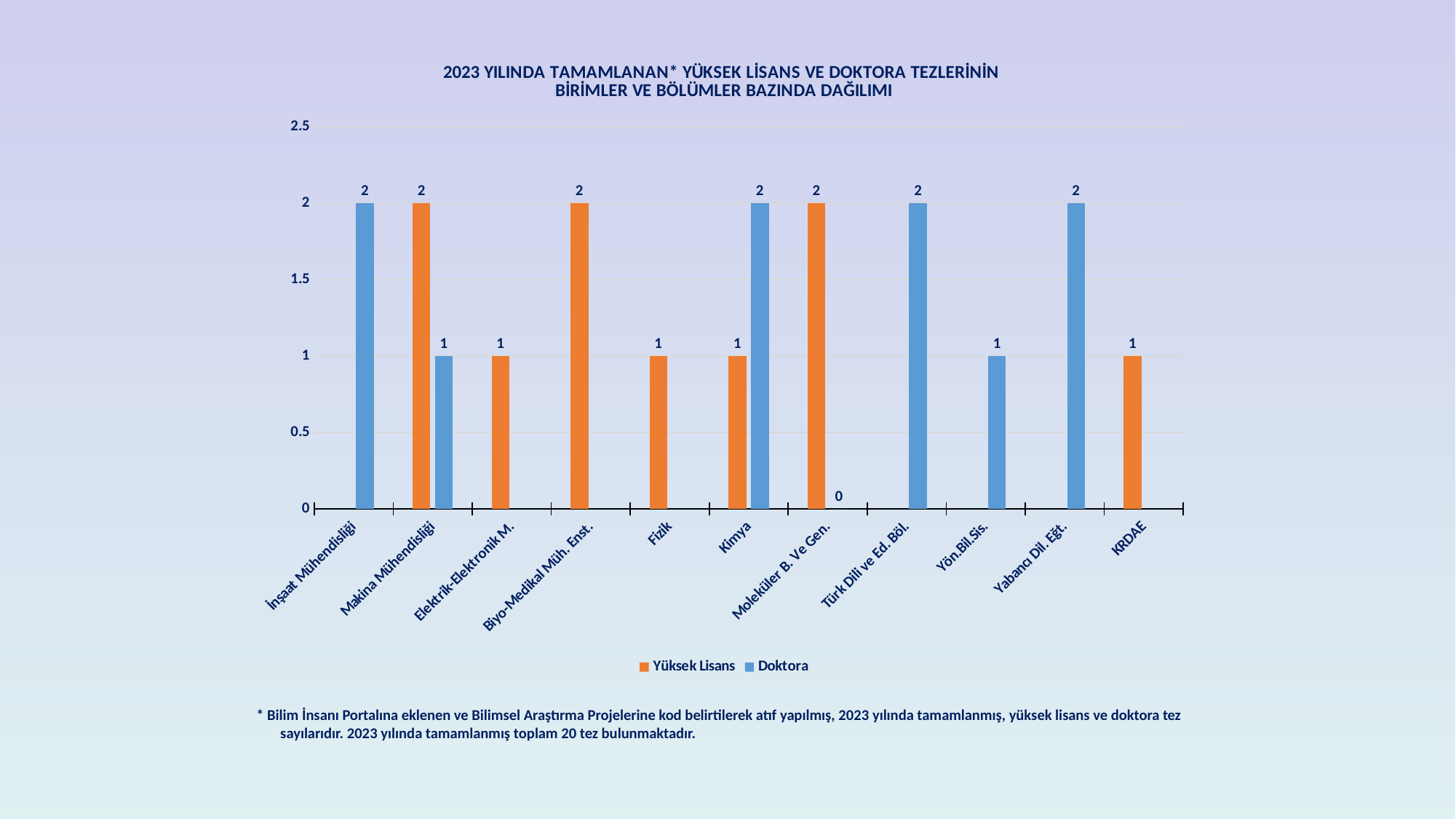
What kind of chart is shown on the slide? Bar chart What is the Yüksek Lisans value for Makina Mühendisliği? 2 What is the highest value shown on the vertical axis? 2.5 What is the Yüksek Lisans value for KRDAE? 1 What is the difference between the Yüksek Lisans and Doktora values for Makina Mühendisliği? 1 What is the Doktora value for Moleküler B. Ve Gen.? 0 How many categories are shown on the x axis? 11 Which series is shown in orange? Yüksek Lisans What is the Doktora value for Yön.Bil.Sis.? 1 What is the Doktora value for Kimya? 2 How many series does the legend list? 2 For Kimya, which is larger: the Yüksek Lisans value or the Doktora value? Doktora